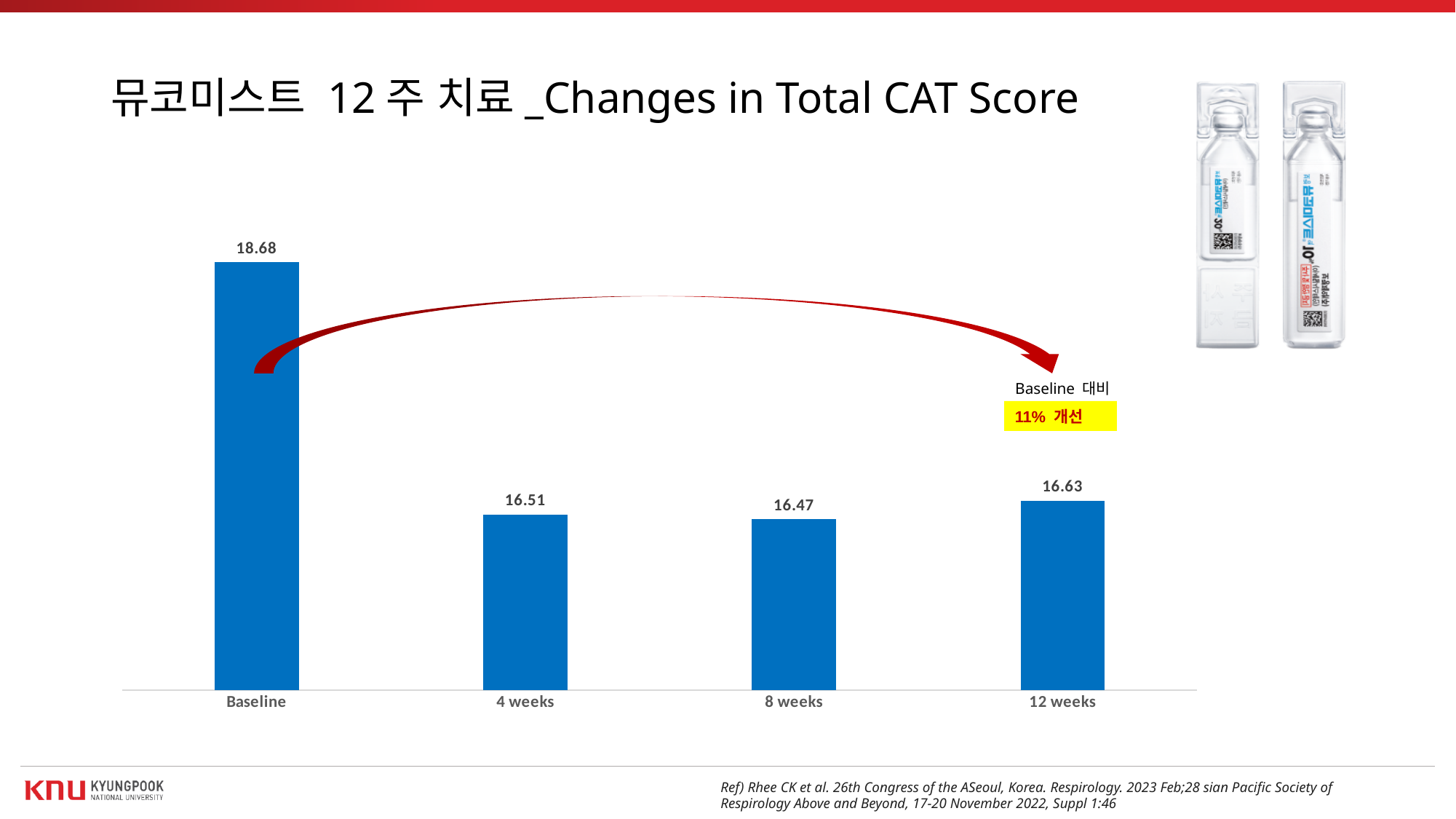
What is the total CAT score at 4 weeks? 16.51 Which is larger, the score at Baseline or the score at 8 weeks? Baseline What is the difference between the Baseline score and the 12 weeks score? 2.05 What kind of chart is shown on the slide? Bar chart What is the total CAT score at Baseline? 18.68 Does the total CAT score rise or fall from Baseline to 4 weeks? Fall What is the total CAT score at 8 weeks? 16.47 How many time points are shown on the chart? 4 What is the total CAT score at 12 weeks? 16.63 Which time point has the highest total CAT score? Baseline What percentage improvement versus Baseline is highlighted on the slide? 11% What is the difference between the 4 weeks score and the 8 weeks score? 0.04